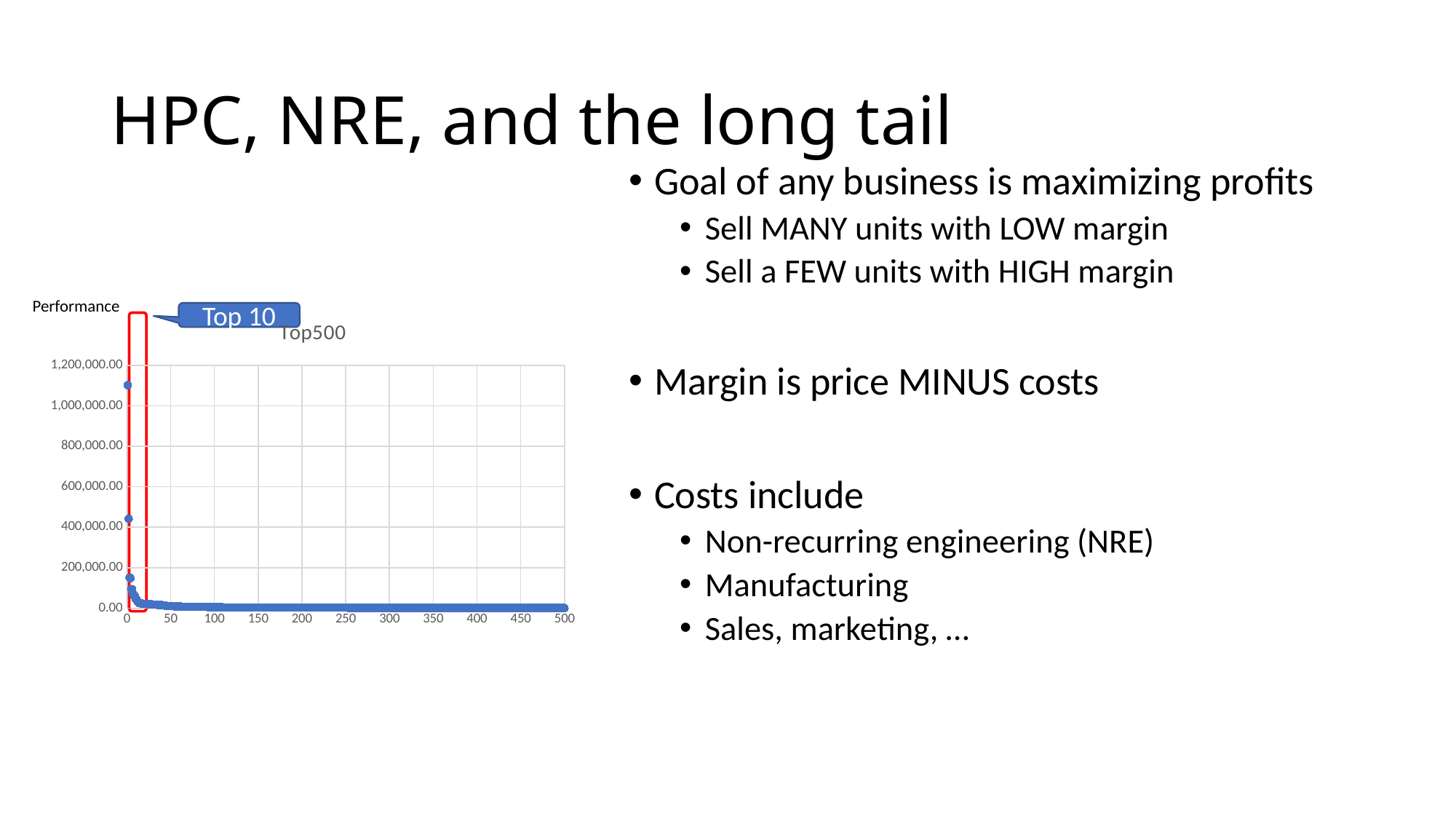
What kind of chart is shown on the slide? scatter chart Do the plotted values rise or fall as the x axis increases from 0 to 500? fall Is the value of the second-highest point on the chart greater or less than 600,000.00? less Is the value plotted at x = 250 greater or less than 200,000.00? less Is the value plotted at x = 500 greater or less than 200,000.00? less What is the title of the chart? Top500 What is the highest value shown on the y axis of the chart? 1,200,000.00 What label is written above the y axis of the chart? Performance Which is larger: the value of the first point (near x = 0) or the value at x = 100? the first point near x = 0